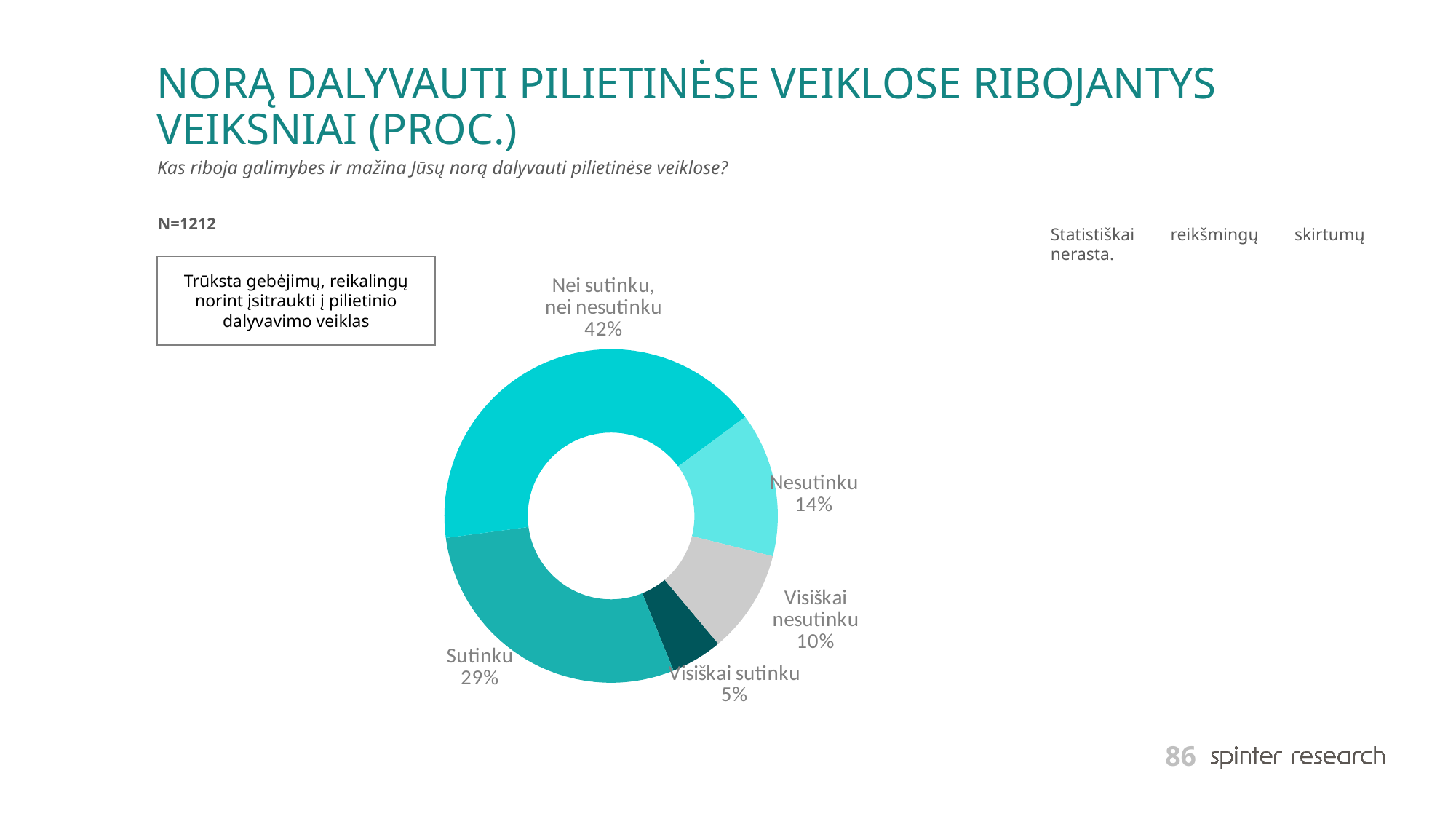
Which is larger, the share for 'Nesutinku' or for 'Visiškai nesutinku'? Nesutinku What kind of chart is shown on the slide? Doughnut (pie) chart Which response category has the largest share? Nei sutinku, nei nesutinku What is the difference in percentage points between 'Sutinku' and 'Nesutinku'? 15 What share of respondents answered 'Visiškai nesutinku'? 10% How many response categories are shown in the chart? 5 What share of respondents answered 'Visiškai sutinku'? 5% What share of respondents answered 'Nesutinku'? 14% What is the sample size (N) stated on the slide? N=1212 What share of respondents answered 'Sutinku'? 29% Which response category has the smallest share? Visiškai sutinku What share of respondents answered 'Nei sutinku, nei nesutinku'? 42%